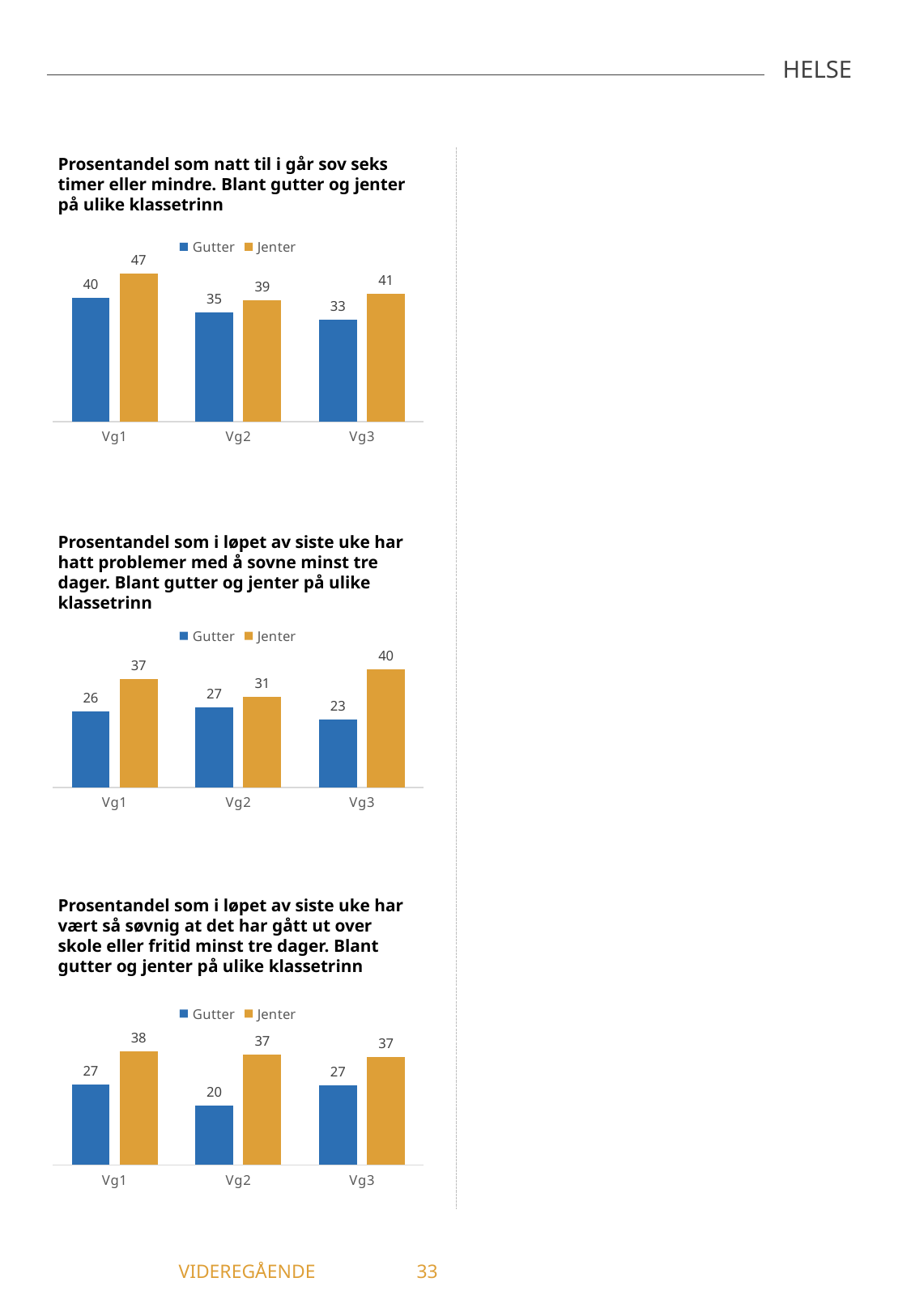
In the middle chart (problems falling asleep), which class level has the lowest Gutter value? Vg3 In the top chart (sleeping six hours or less), what is the value for Jenter at Vg1? 47 In the bottom chart (so sleepy it affected school or leisure), what is the value for Gutter at Vg2? 20 In the bottom chart (so sleepy it affected school or leisure), what is the difference between Jenter and Gutter at Vg1? 11 In the top chart (sleeping six hours or less), do the Gutter values rise or fall from Vg1 to Vg3? fall In the middle chart (problems falling asleep), which class level has the highest Jenter value? Vg3 In the bottom chart (so sleepy it affected school or leisure), which is larger at Vg3, Gutter or Jenter? Jenter In the middle chart (problems falling asleep), what is the value for Jenter at Vg2? 31 How many series does the legend of the middle chart list? 2 What kind of chart is the bottom chart? bar chart In the top chart (sleeping six hours or less), what is the difference between Jenter and Gutter at Vg2? 4 In the top chart (sleeping six hours or less), what is the value for Gutter at Vg3? 33